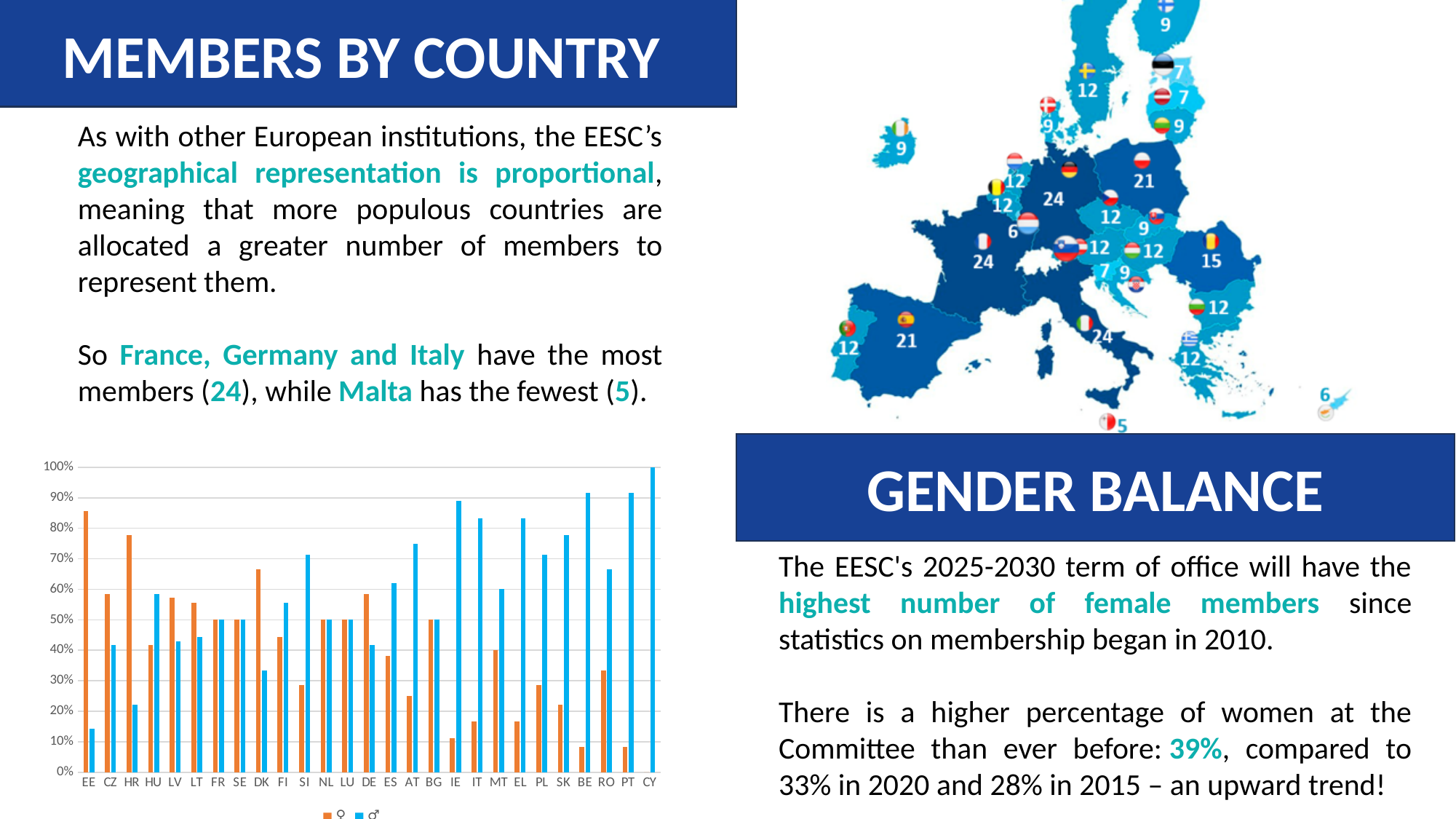
In the bar chart, is the female (♀) value for EE greater or less than 80%? greater How many countries are shown on the x axis of the bar chart? 27 How many series does the legend of the bar chart list? 2 In the bar chart, which country has the highest female (♀) share? EE In the bar chart, what is the male (♂) share for CY? 100% In the bar chart, is the male (♂) value for IE greater or less than 80%? greater In the bar chart, what is the female (♀) share for FR? 50% In the bar chart, which country has the highest male (♂) share? CY In the bar chart, which country has the lowest male (♂) share? EE What kind of chart is shown at the bottom left of the slide? bar chart In the bar chart, which is larger: the female (♀) share for HR or the female (♀) share for HU? HR In the bar chart, is the female (♀) value for PT greater or less than 10%? less